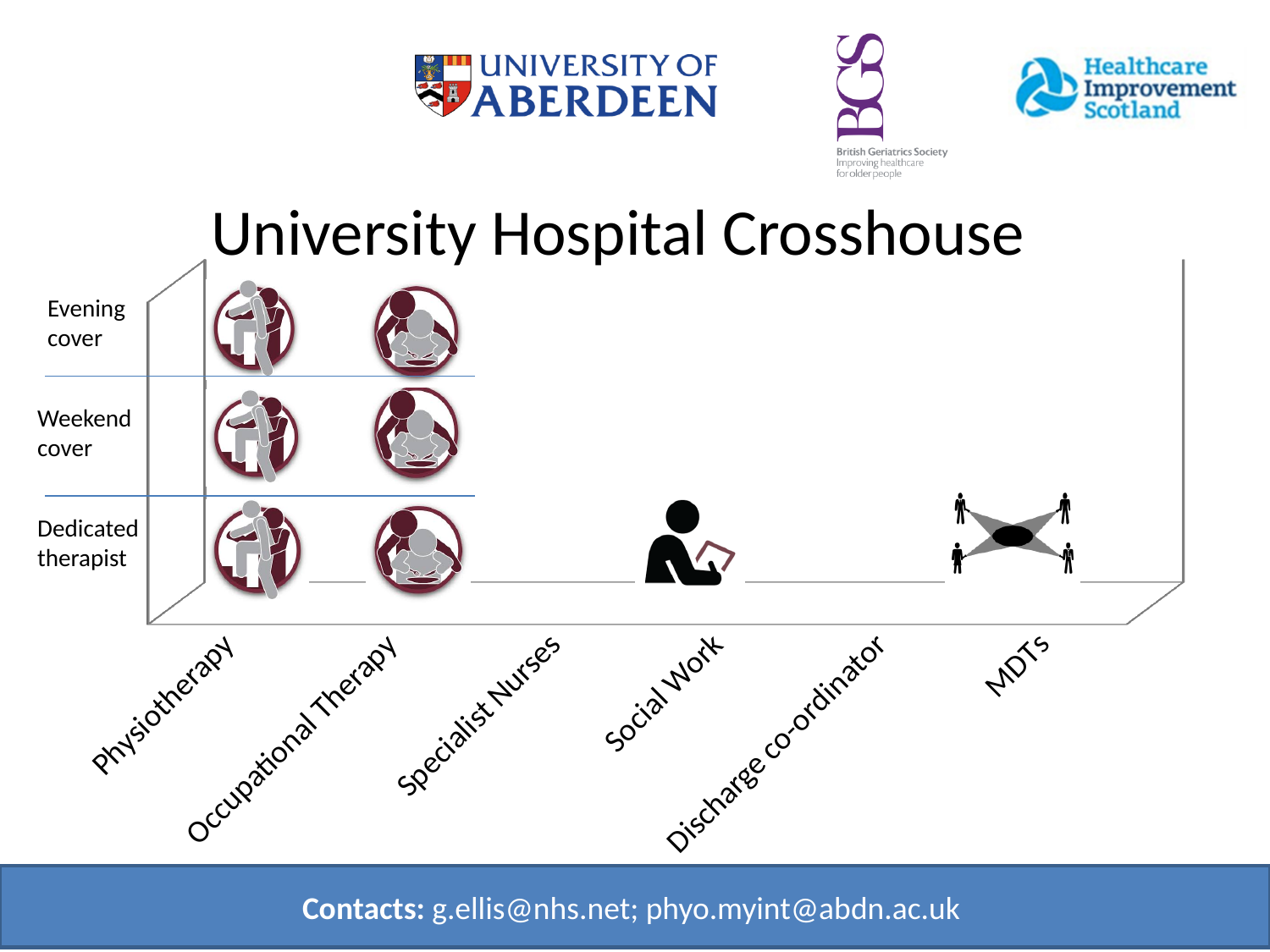
How many icons are shown for MDTs in the chart? 1 What are the three levels labelled on the vertical axis, from bottom to top? Dedicated therapist, Weekend cover, Evening cover Does Physiotherapy have weekend cover according to the chart? Yes Which level does MDTs reach in the chart? Dedicated therapist Which level does Social Work reach in the chart? Dedicated therapist How many icons are shown for Physiotherapy in the chart? 3 How many levels are labelled on the vertical axis of the chart? 3 Which categories reach the 'Evening cover' level in the chart? Physiotherapy and Occupational Therapy Which categories have no icons at any level in the chart? Specialist Nurses and Discharge co-ordinator Which reaches a higher level in the chart, Occupational Therapy or Social Work? Occupational Therapy What is the title of the chart on the slide? University Hospital Crosshouse